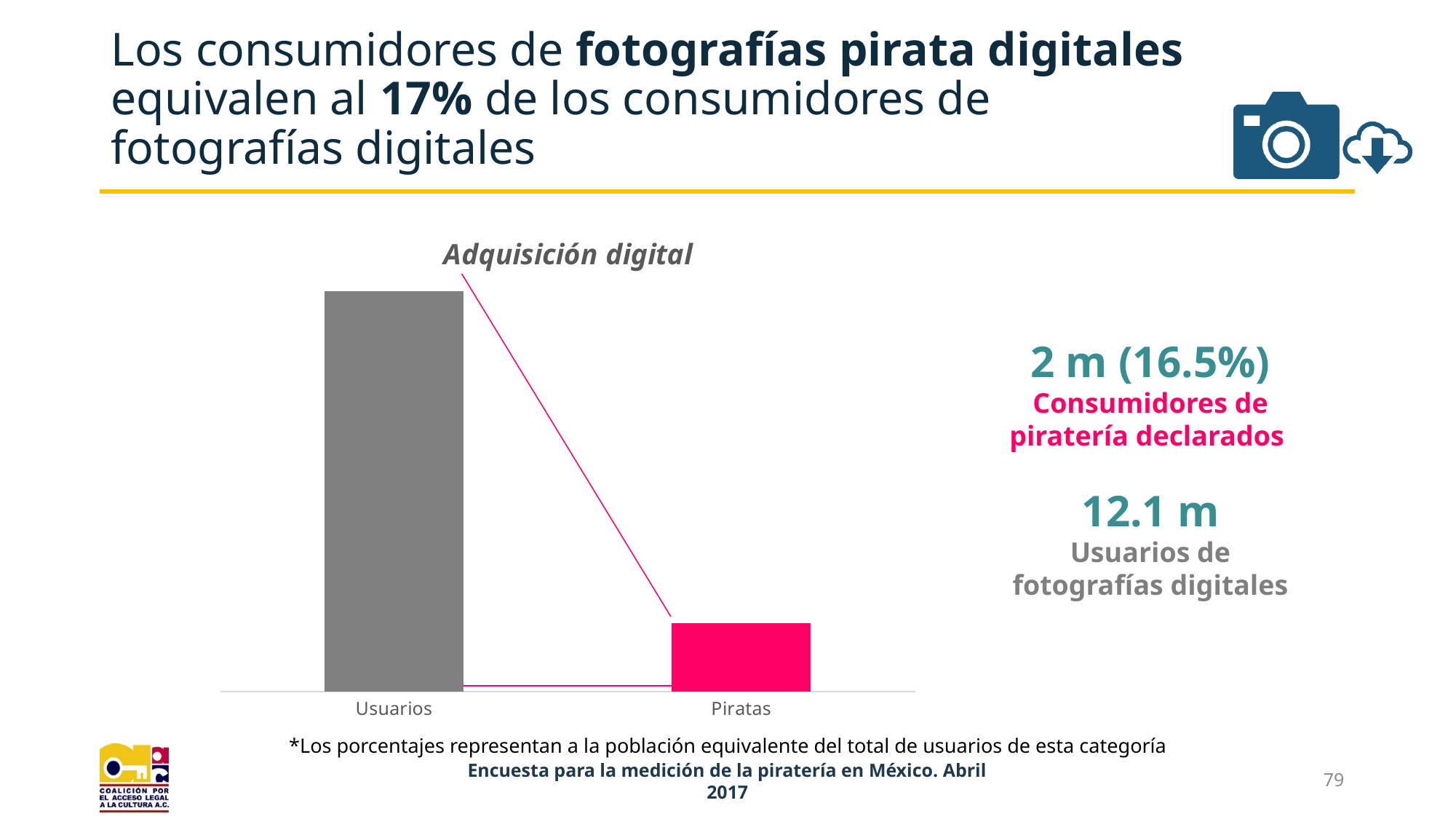
Is the bar for Usuarios larger or smaller than the bar for Piratas? larger What is the title of the chart? Adquisición digital Which category has the taller bar, Usuarios or Piratas? Usuarios According to the figures printed beside the chart, how many declared piracy consumers (Piratas) are there? 2 m What are the two category labels on the x axis? Usuarios and Piratas What colour is the Piratas bar? pink What is the difference between the Usuarios value (12.1 m) and the Piratas value (2 m)? 10.1 m According to the figures printed beside the chart, how many users of digital photographs (Usuarios) are there? 12.1 m Which category has the shorter bar? Piratas How many bars does the chart show? 2 What percentage of digital photograph users do the declared piracy consumers represent, as printed beside the chart? 16.5% What kind of chart is shown on the slide? bar chart